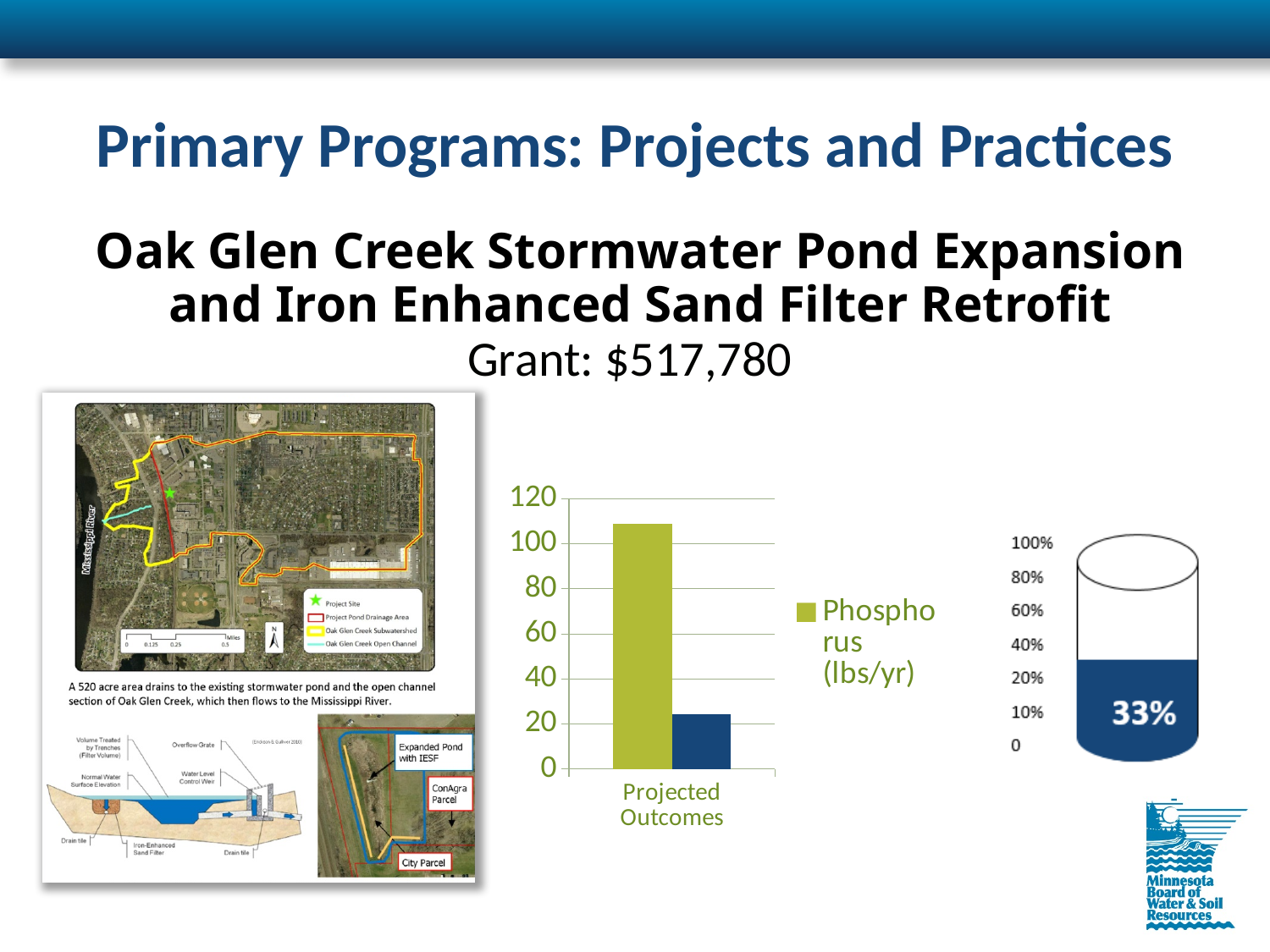
How many categories are shown on the x axis of the bar chart? 1 In the bar chart, which bar is taller, the green Phosphorus (lbs/yr) bar or the blue bar? the green Phosphorus (lbs/yr) bar What is the highest value shown on the y axis of the bar chart? 120 How many series does the legend of the bar chart list? 1 In the bar chart, is the value of the blue bar greater or less than 20? greater What percentage is printed on the cylinder gauge on the right side of the slide? 33% In the bar chart, what is the only category label shown on the x axis? Projected Outcomes In the bar chart, is the value of the green Phosphorus (lbs/yr) bar greater or less than 100? greater In the bar chart, is the value of the green Phosphorus (lbs/yr) bar greater or less than 120? less What series name appears in the legend of the bar chart? Phosphorus (lbs/yr) What kind of chart is shown in the middle of the slide? bar chart